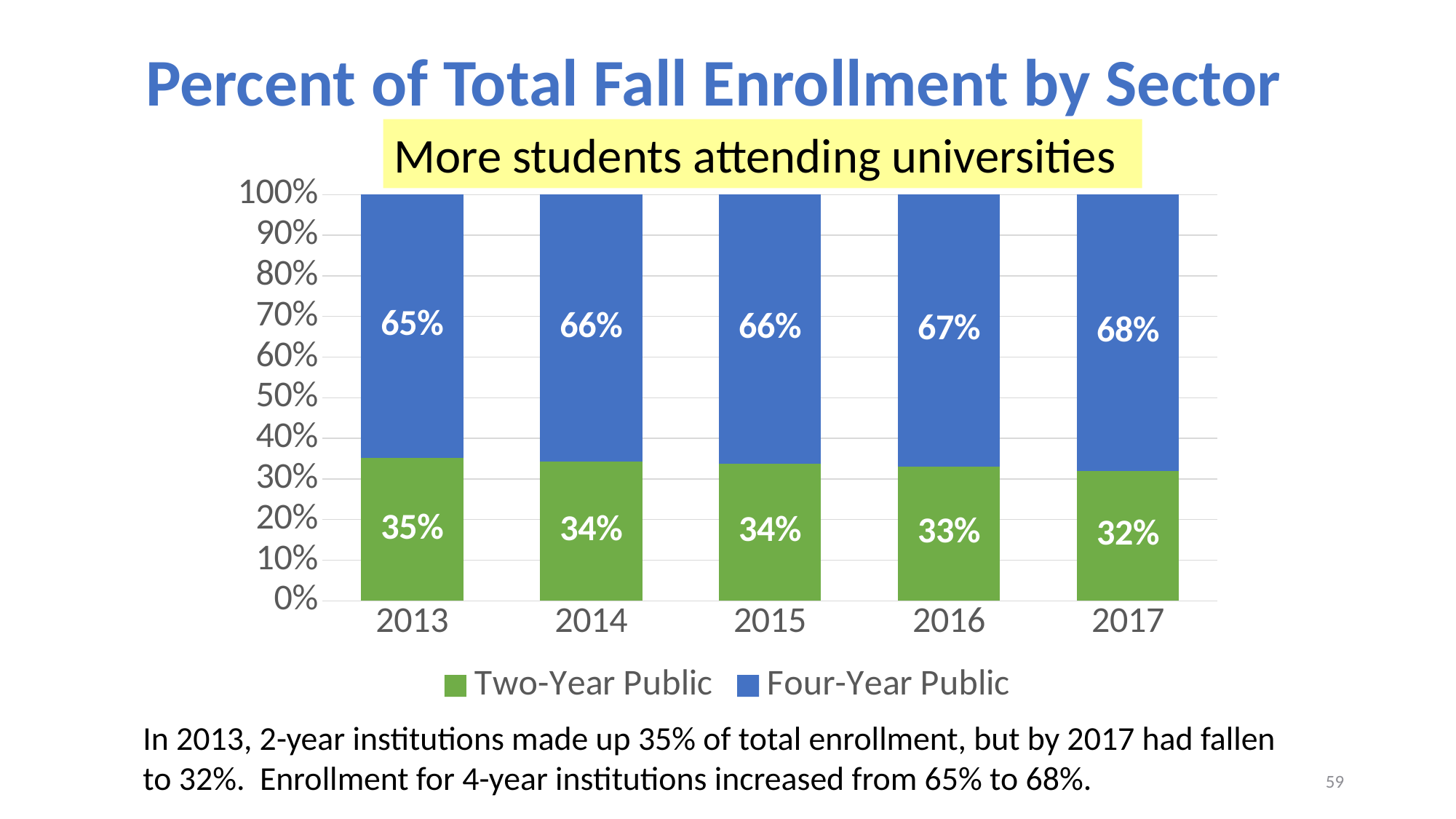
What percent of total fall enrollment was Two-Year Public in 2013? 35% What percent of total fall enrollment was Four-Year Public in 2017? 68% What is the difference between the Four-Year Public and Two-Year Public shares in 2016? 34% How many years are shown on the x axis? 5 What kind of chart is shown on the slide? Stacked bar chart Which is larger in 2014, the Two-Year Public share or the Four-Year Public share? Four-Year Public What colour represents Four-Year Public in the chart? Blue Does the Two-Year Public share rise or fall from 2013 to 2017? Fall What is the Four-Year Public value for 2015? 66% In which year is the Two-Year Public share the lowest? 2017 In which year is the Four-Year Public share the highest? 2017 How many series does the legend list? 2